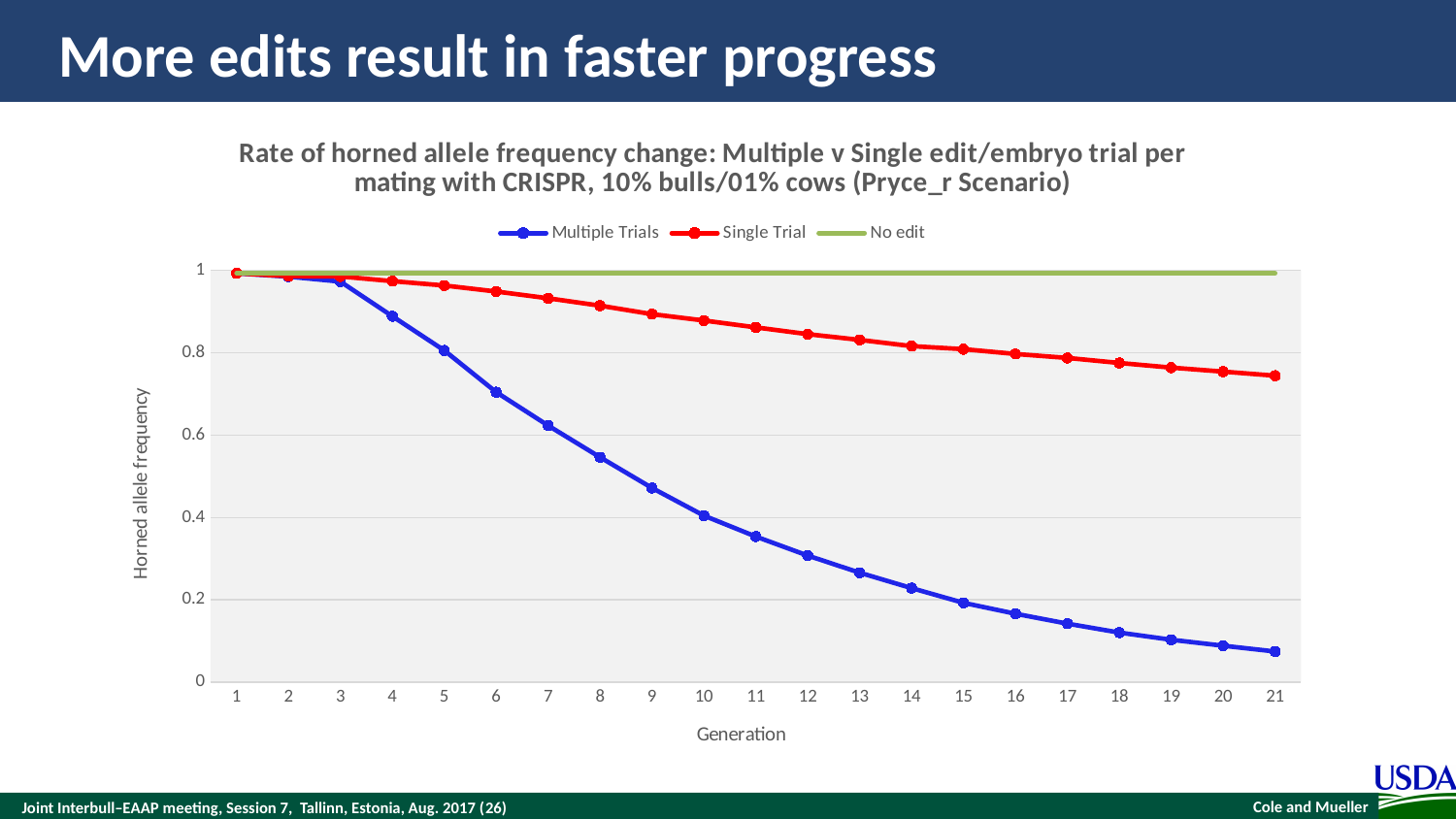
Which colour is used for the No edit series? green Is the Multiple Trials value at generation 5 greater or less than 0.6? greater What is the label of the y axis? Horned allele frequency Which series has the lowest horned allele frequency at generation 21? Multiple Trials Is the Multiple Trials value at generation 10 greater or less than 0.6? less How many generations are plotted along the x axis? 21 Does the Multiple Trials series rise or fall as generation increases? fall Does the Single Trial series rise or fall as generation increases? fall How many series does the legend list? 3 What kind of chart is shown on the slide? line chart At generation 15, which series has the higher horned allele frequency, Single Trial or Multiple Trials? Single Trial Is the Single Trial value at generation 21 greater or less than 0.6? greater